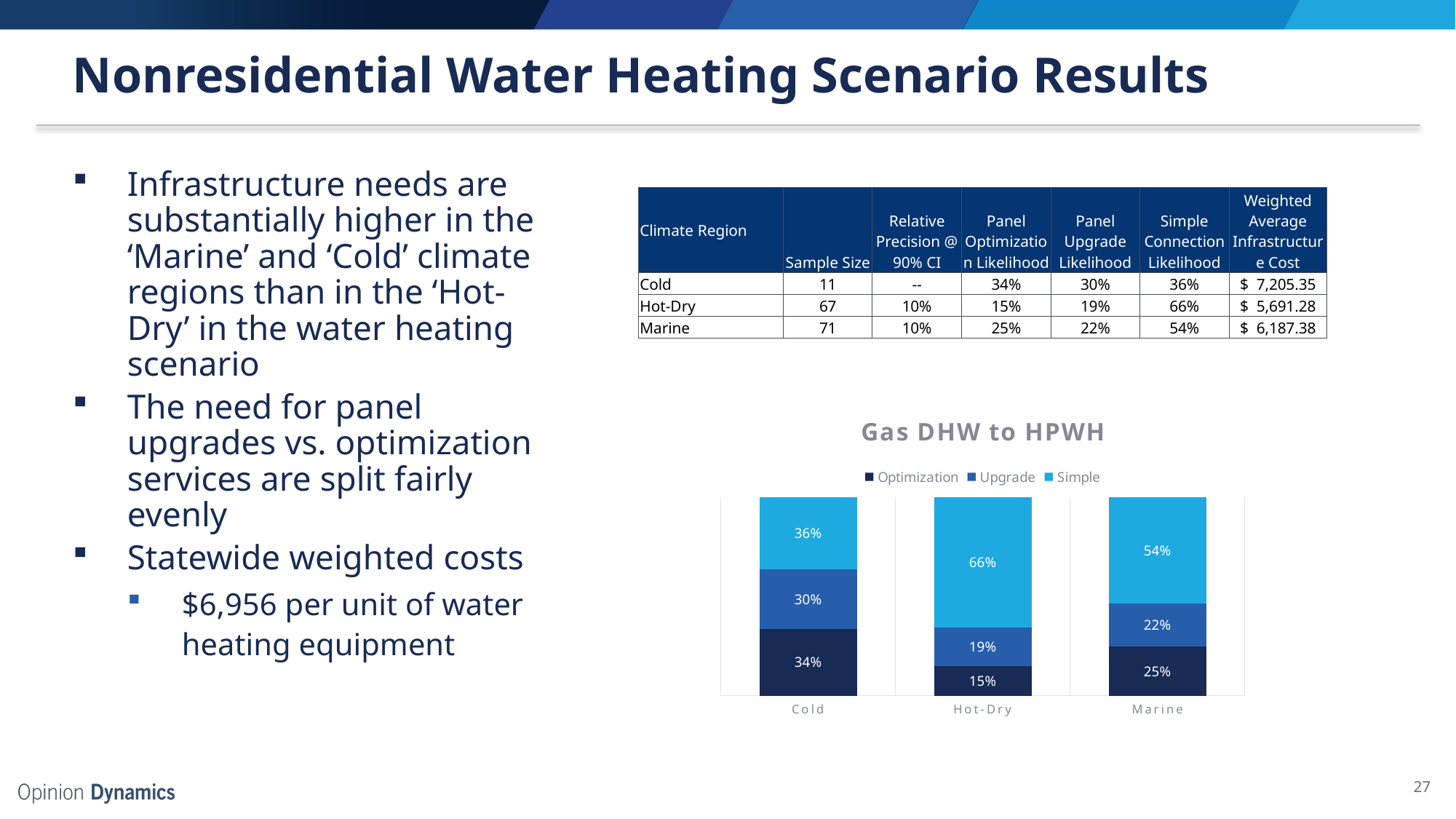
What is the Simple value for Hot-Dry in the chart? 66% What is the Upgrade value for Marine in the chart? 22% What is the difference between the Simple values for Hot-Dry and Cold in the chart? 30% What kind of chart is shown on the slide? Stacked bar chart What is the total of the stacked bar for Marine in the chart? 101% Which climate region has the highest Simple value in the chart? Hot-Dry Which climate region has the lowest Optimization value in the chart? Hot-Dry Which is larger in the chart: the Upgrade value for Cold or the Upgrade value for Marine? Cold How many series does the chart legend list? 3 What is the Optimization value for Cold in the chart? 34% What is the title of the chart? Gas DHW to HPWH How many climate regions are shown on the x axis of the chart? 3